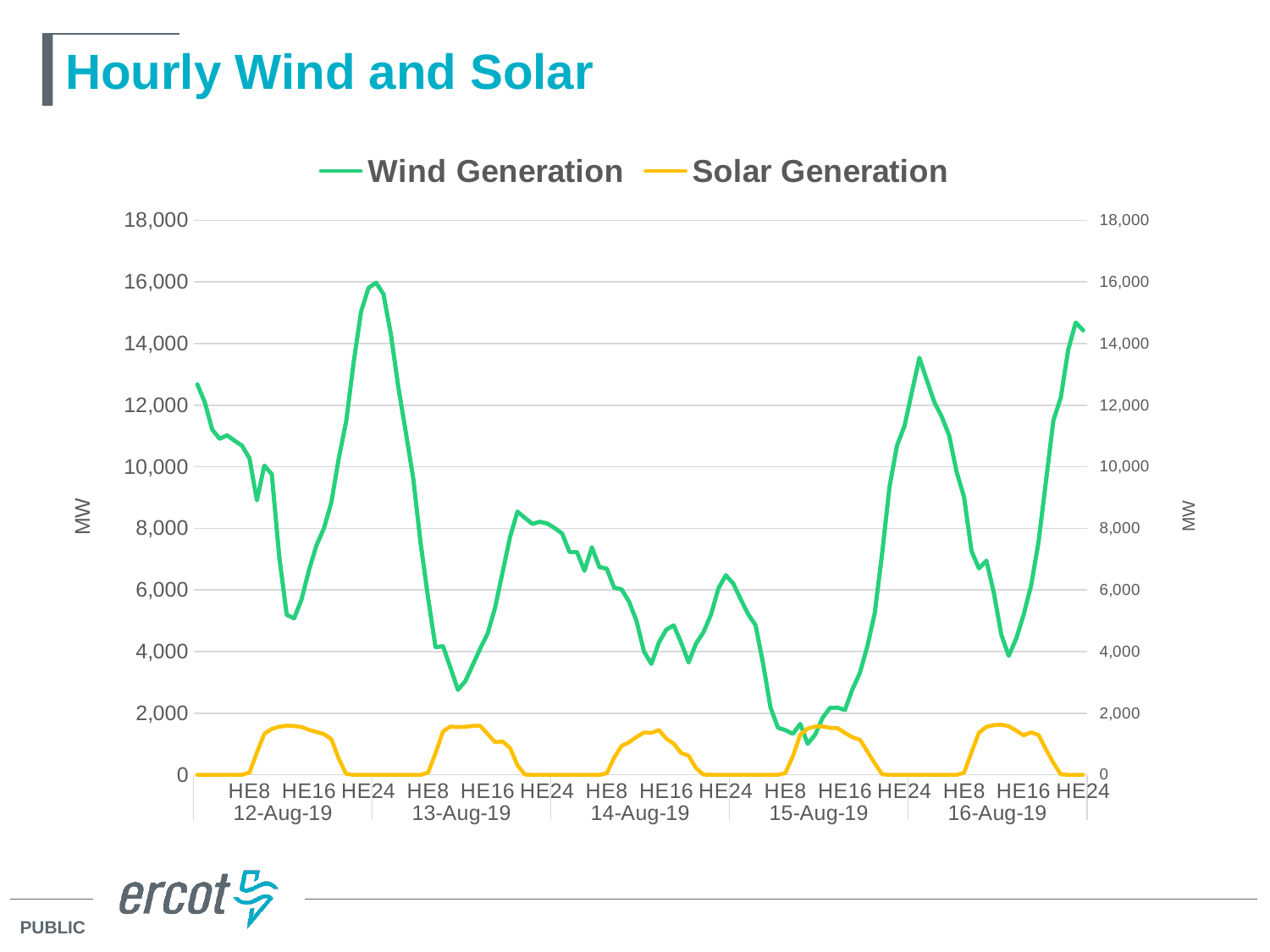
Does Wind Generation rise or fall between HE8 and HE16 on 12-Aug-19? fall Is the highest Wind Generation value on 16-Aug-19 greater or less than 12,000? greater At HE8 on 12-Aug-19, which is larger, Wind Generation or Solar Generation? Wind Generation How many series does the legend list? 2 What is the title of the chart? Hourly Wind and Solar What unit is shown on the y axis? MW How many dates are labelled along the x axis? 5 Is the Wind Generation value at the start of 12-Aug-19 greater or less than 12,000? greater Which series reaches the higher peak value over the period, Wind Generation or Solar Generation? Wind Generation Is the peak value of Solar Generation greater or less than 2,000? less What kind of chart is shown on the slide? Line chart